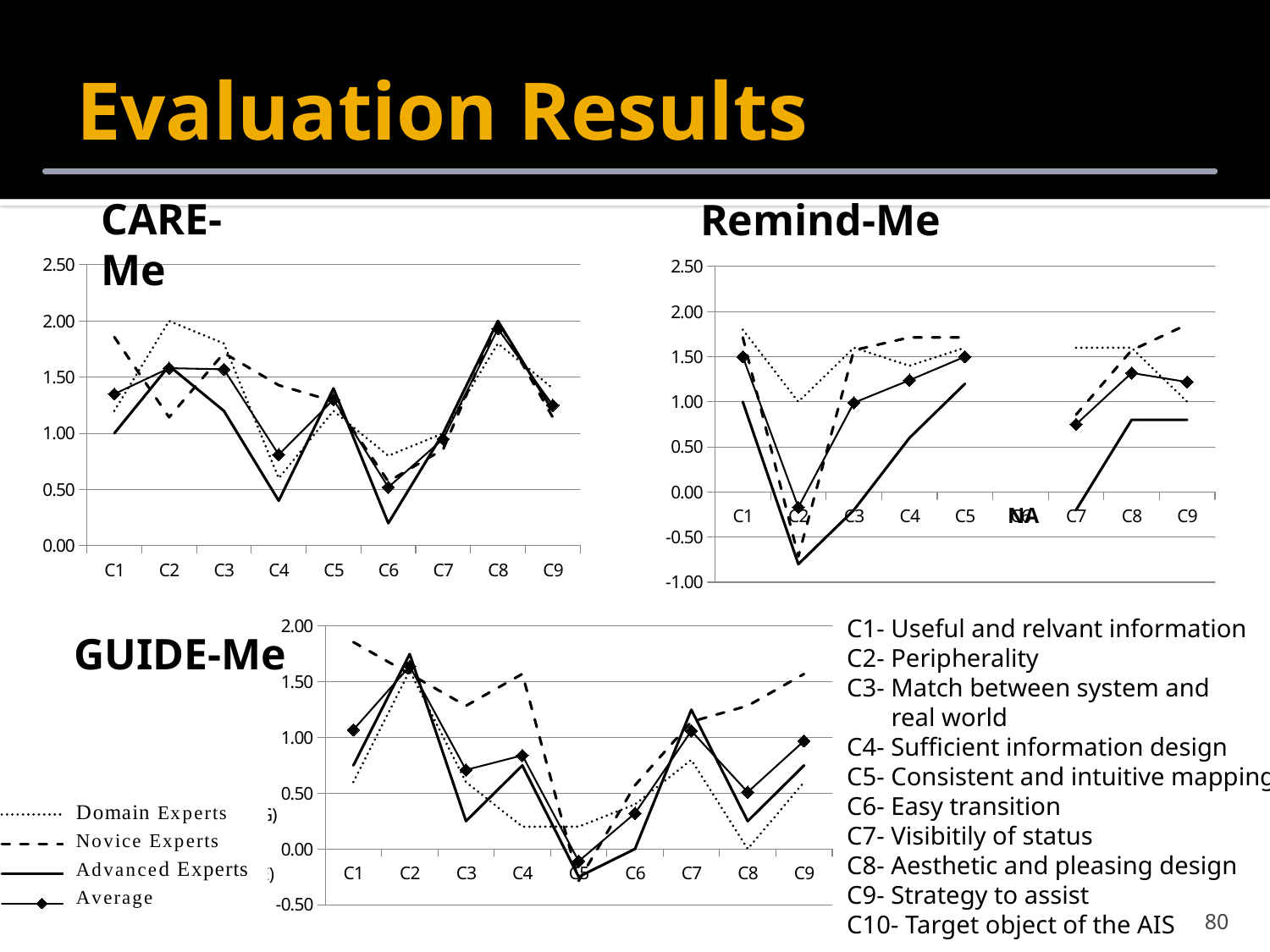
In the GUIDE-Me chart, at which category is the Average series lowest? C5 In the Remind-Me chart, is the Advanced Experts value for C2 greater or less than -0.50? less In the GUIDE-Me chart, which is larger for the Average series: the value for C7 or the value for C8? C7 In the CARE-Me chart, at which category is the Average series lowest? C6 In the CARE-Me chart, is the Average value for C8 greater or less than 1.50? greater How many series does the legend list for the charts? 4 In the GUIDE-Me chart, is the Average value for C5 greater or less than 0.50? less In the Remind-Me chart, does the Average series rise or fall from C2 to C5? rise In the CARE-Me chart, at which category is the Average series highest? C8 In the Remind-Me chart, at which category is the Average series lowest? C2 How many categories are shown on the x axis of the GUIDE-Me chart? 9 What kind of chart is the CARE-Me chart? line chart